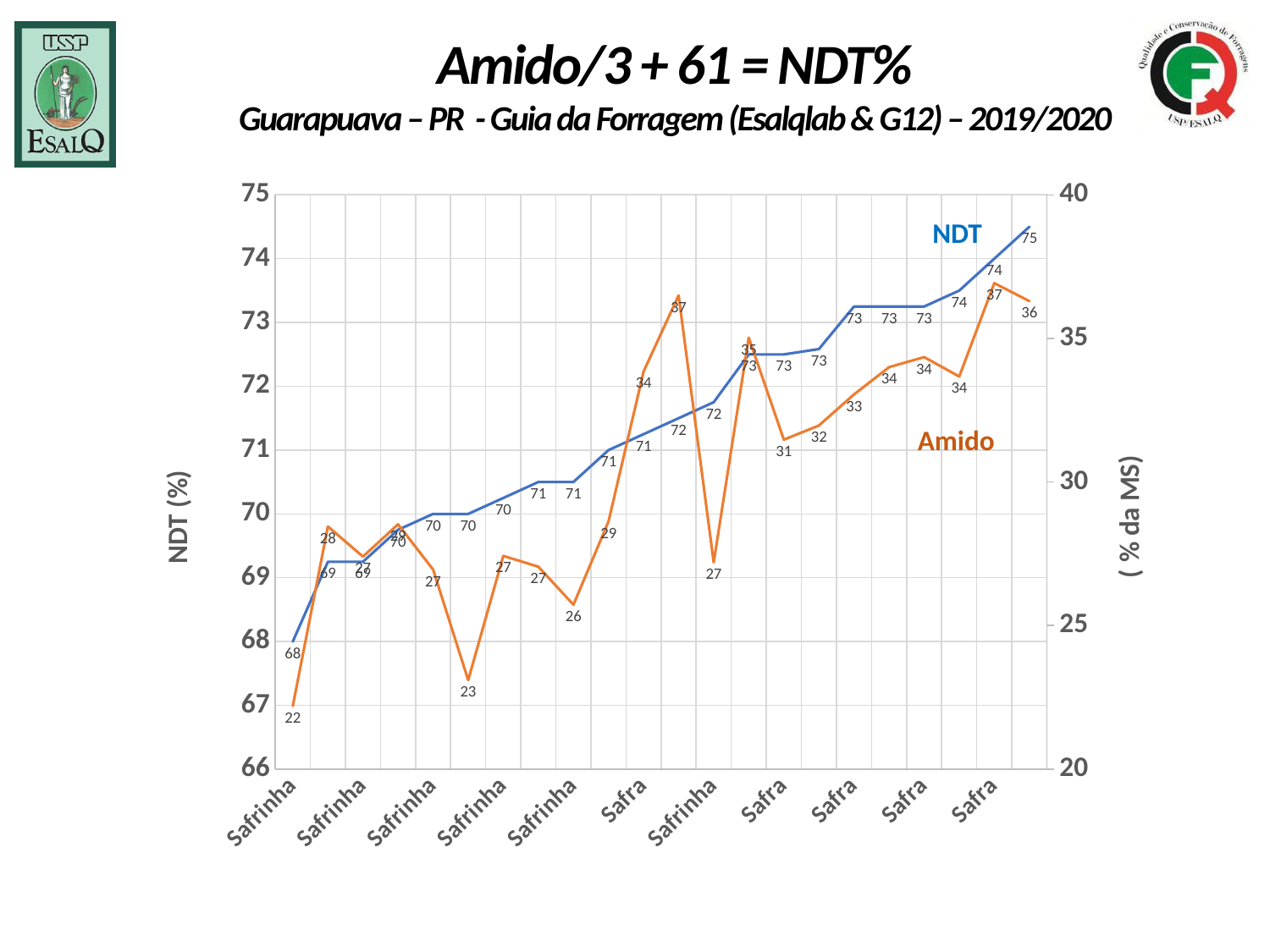
Does the NDT line generally rise or fall from left to right? rise What is the highest Amido value shown on the chart? 37 What is the last (rightmost) NDT value on the chart? 75 What is the first (leftmost) NDT value on the chart? 68 How many data series are plotted on the chart? 2 What kind of chart is shown on the slide? line chart What is the lowest NDT value shown on the chart? 68 By how much does the last NDT value exceed the first NDT value? 7 What is the lowest Amido value shown on the chart? 22 What is the first (leftmost) Amido value on the chart? 22 What is the last (rightmost) Amido value on the chart? 36 Which series is drawn in blue? NDT